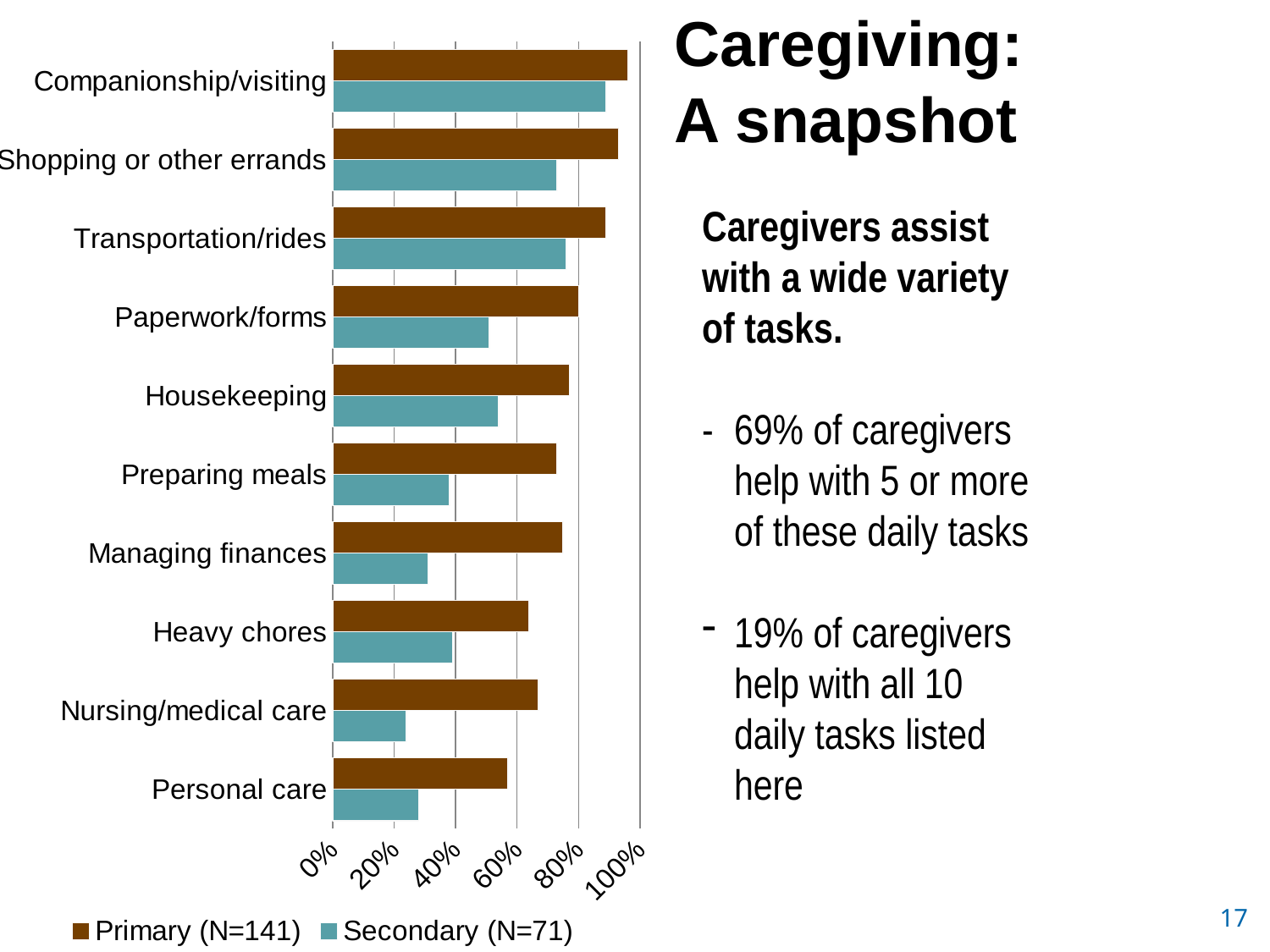
For Nursing/medical care, which series has the larger value, Primary or Secondary? Primary How many series does the chart legend list? 2 Is the Primary (N=141) value for Paperwork/forms greater or less than 60%? greater Is the Secondary (N=71) value for Nursing/medical care greater or less than 40%? less What are the two series named in the legend? Primary (N=141) and Secondary (N=71) Which task has the highest value for the Secondary (N=71) series? Companionship/visiting What kind of chart is shown on the slide? bar chart Is the Secondary (N=71) value for Managing finances greater or less than 40%? less What sample size is given for the Primary series in the legend? N=141 How many task categories are shown in the chart? 10 Which task has the highest value for the Primary (N=141) series? Companionship/visiting Which task has the lowest value for the Primary (N=141) series? Personal care